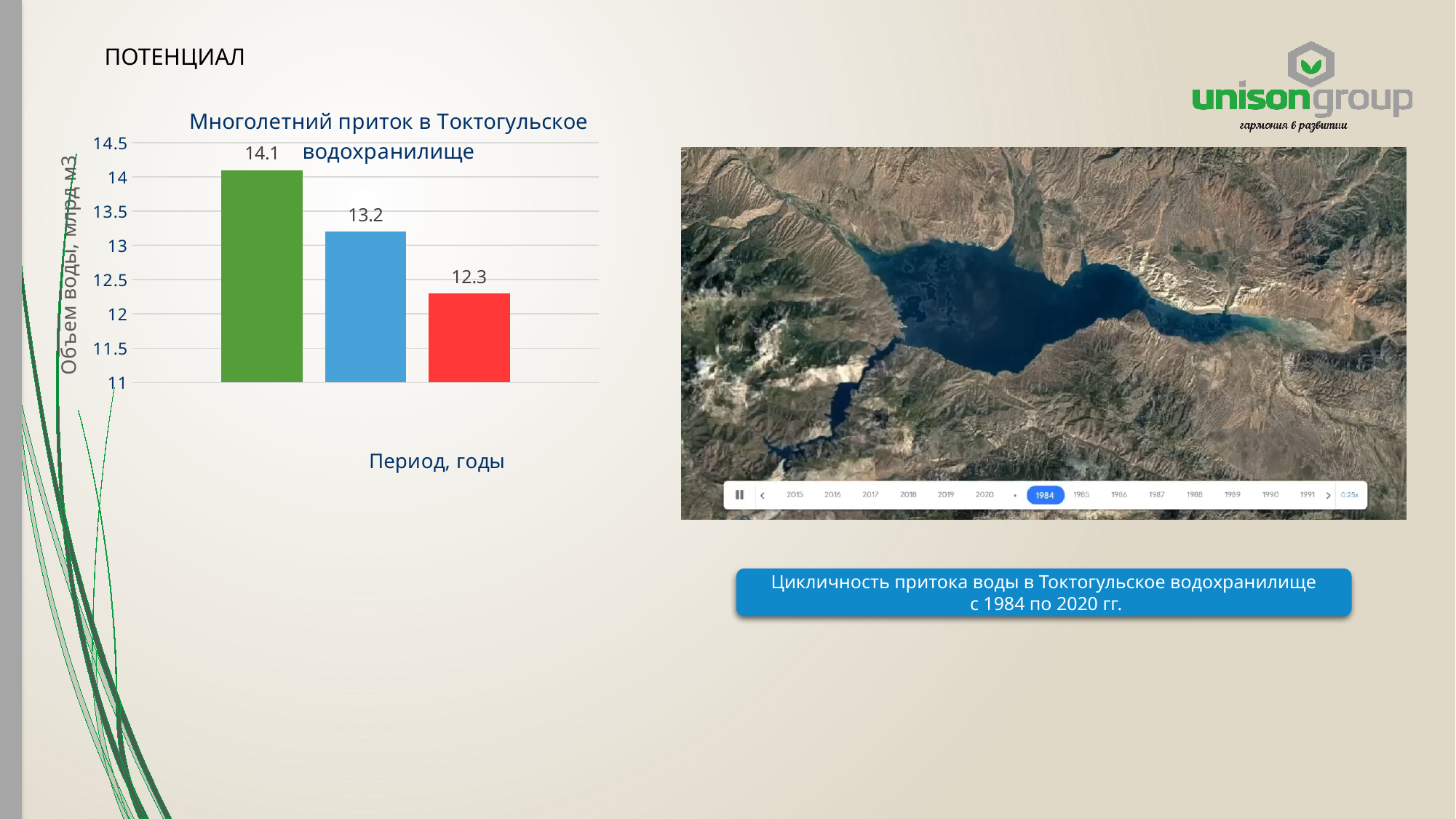
What is the value shown on the green bar in the chart? 14.1 What is the value shown on the blue bar in the chart? 13.2 Which bar has the lowest value in the chart? The red bar (12.3) Which bar has the highest value in the chart? The green bar (14.1) What is the difference between the green bar and the blue bar values? 0.9 What is the difference between the green bar and the red bar values? 1.8 What is the title of the chart? Многолетний приток в Токтогульское водохранилище How many bars are plotted in the chart? 3 Do the bar values rise or fall from left to right? Fall What type of chart is shown on the slide? Bar chart Which is larger, the blue bar or the red bar? The blue bar What is the value shown on the red bar in the chart? 12.3